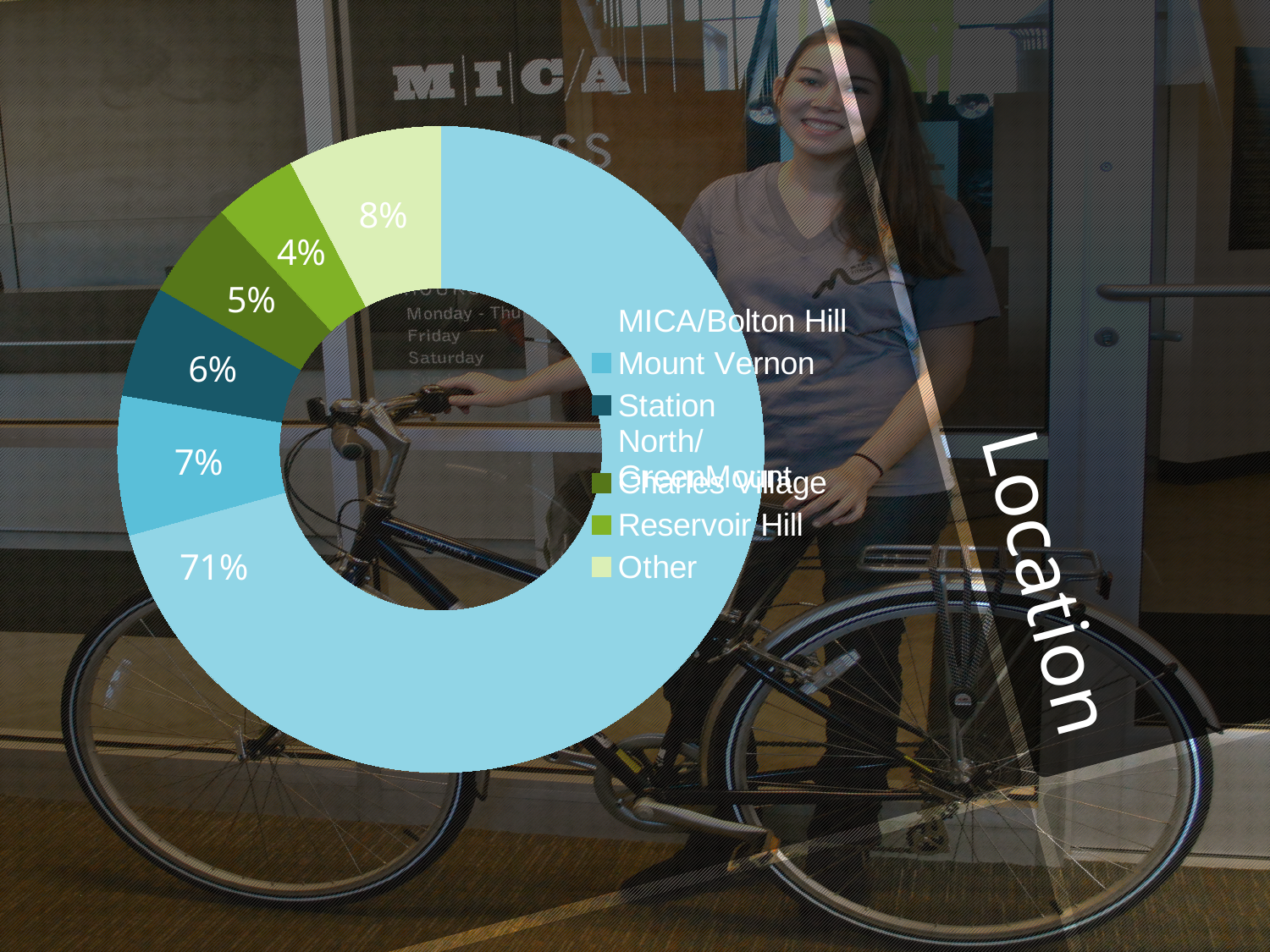
Which location has the largest share of the chart? MICA/Bolton Hill What kind of chart is shown on the slide? Doughnut (pie) chart Which has a larger share, Mount Vernon or Charles Village? Mount Vernon Which location has the smallest share of the chart? Reservoir Hill What percentage of the chart is Other? 8% What percentage of the chart is Mount Vernon? 7% What percentage of the chart is MICA/Bolton Hill? 71% How many categories does the legend list? 6 What is the combined share of Mount Vernon and Station North/GreenMount? 13% What is the difference in percentage points between MICA/Bolton Hill and Other? 63 What percentage of the chart is Reservoir Hill? 4% What is the title of the chart? Location